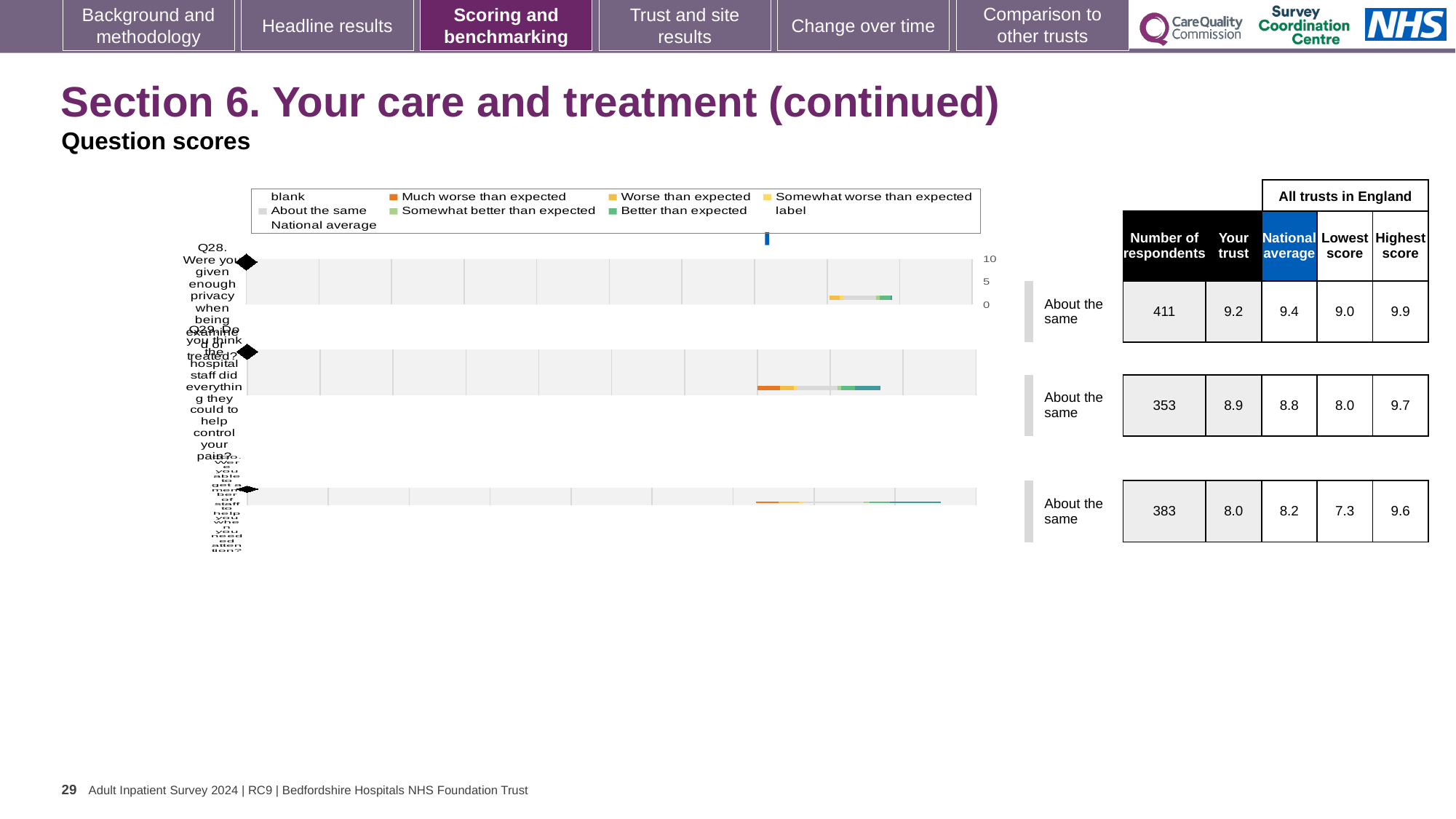
What kind of chart is shown on the slide? bar chart Which question has the lowest number of respondents? Q29 How many questions (categories) are plotted in the chart? 3 What is the difference between the highest score and the lowest score for Q28? 0.9 For Q28, which is larger: the 'Your trust' score or the national average? National average How many respondents answered Q30? 383 What is the national average score for Q29 (staff did everything to help control your pain)? 8.8 For Q30, what is the difference between the national average and the 'Your trust' score? 0.2 Which question has the highest 'Your trust' score? Q28 What is the 'Your trust' score for Q28 (privacy when being examined or treated)? 9.2 What benchmark category is shown for Q30? About the same What is the maximum value shown on the chart's score axis? 10